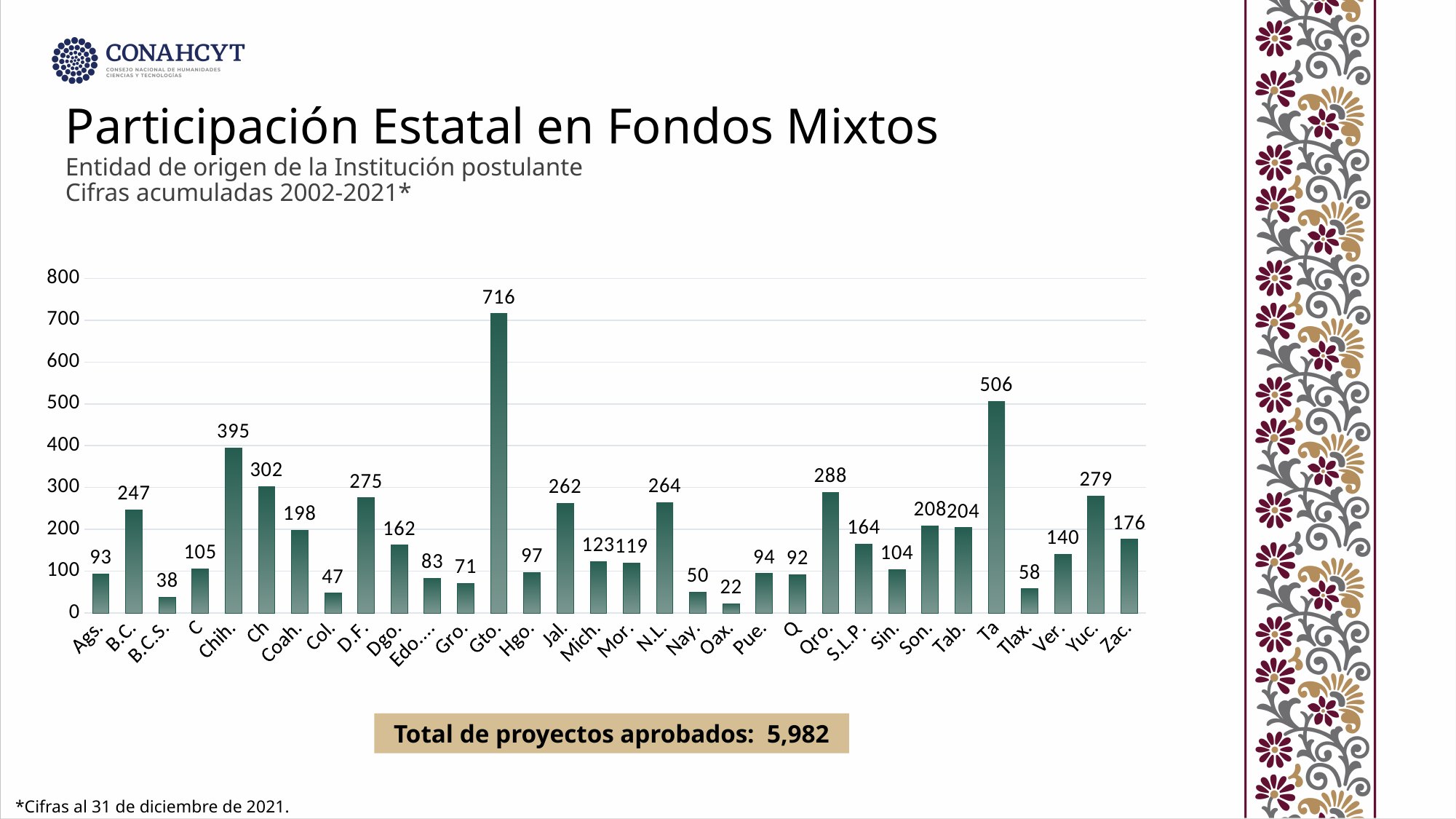
How many categories are shown on the x axis? 32 What kind of chart is shown on the slide? Bar chart What is the value for Gto.? 716 Which category has the highest value? Gto. What is the difference between the values for Gto. and Ta? 210 What total number of approved projects is stated below the chart? 5,982 Which category has the lowest value? Oax. What is the value for Yuc.? 279 What is the difference between the values for Jal. and N.L.? 2 Which is larger, the value for Chih. or the value for Ch? Chih. What is the value for Chih.? 395 What is the value for Oax.? 22